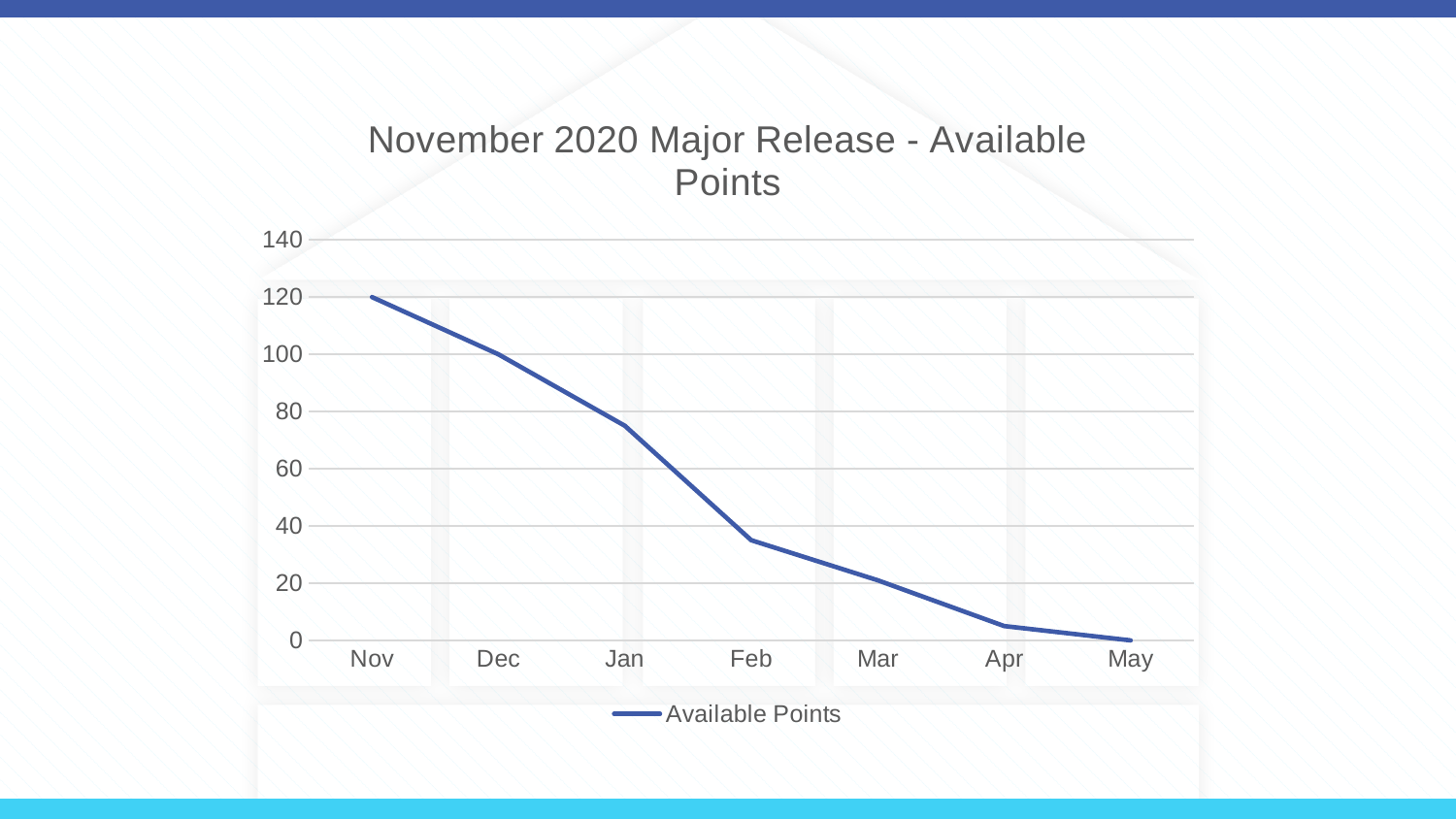
What kind of chart is shown on the slide? line chart What is the value of Available Points for Dec? 100 How many series does the legend list? 1 What is the difference between the Available Points for Nov and Dec? 20 Which month has the highest Available Points? Nov Which month has the lowest Available Points? May Is the value for Jan greater or less than 60? greater Do the Available Points rise or fall from Nov to May? fall How many months are plotted along the x axis? 7 What is the value of Available Points for Nov? 120 What is the value of Available Points for May? 0 What is the title of the chart? November 2020 Major Release - Available Points